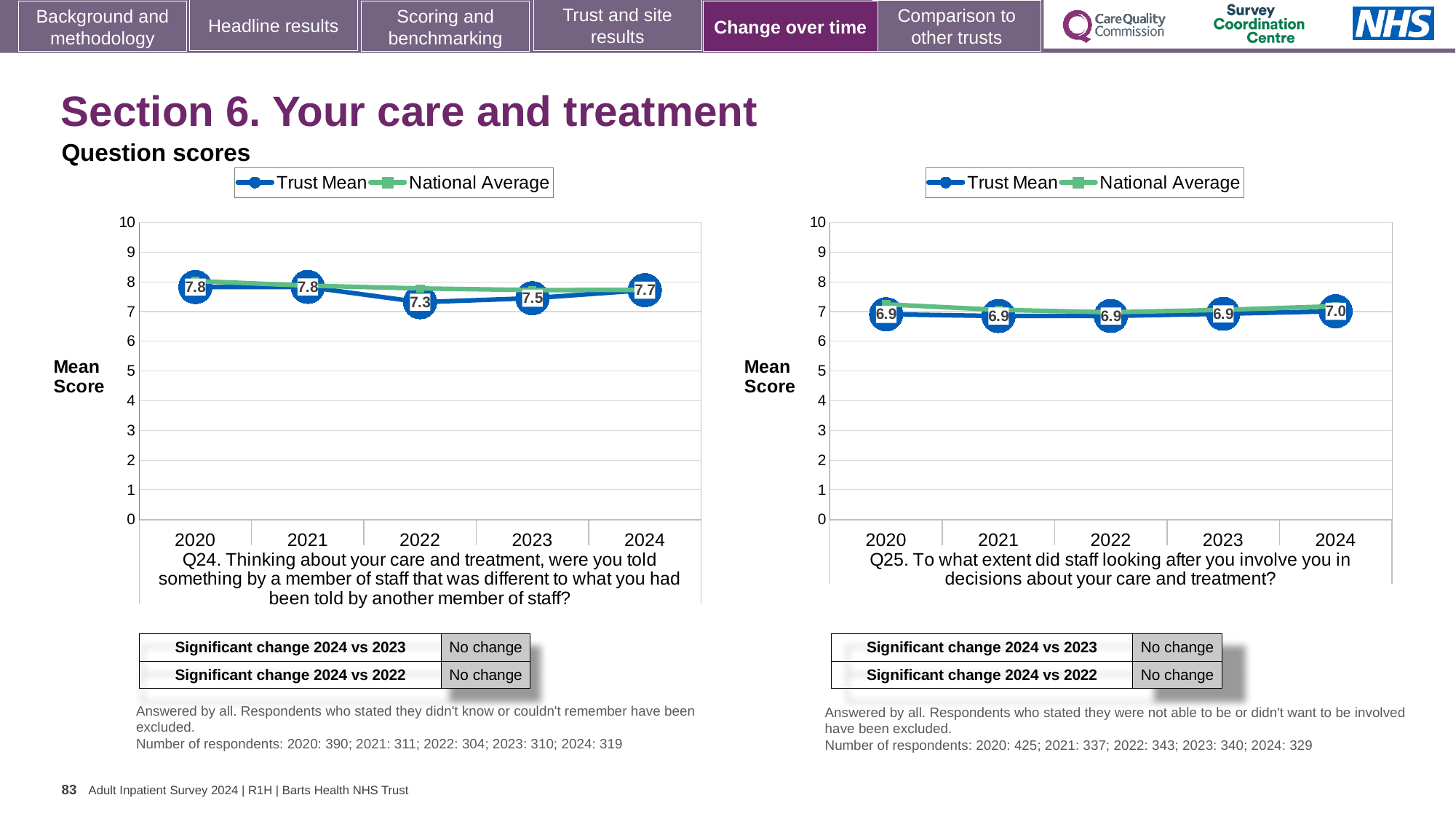
In the Q24 chart on the left, which year has the larger Trust Mean score, 2020 or 2023? 2020 In the Q25 chart on the right, what is the Trust Mean score for 2024? 7.0 In the Q24 chart on the left, which year has the lowest Trust Mean score? 2022 In the Q24 chart on the left, what is the Trust Mean score for 2022? 7.3 What are the two series named in the legend of the Q25 chart on the right? Trust Mean and National Average What kind of chart is the Q25 chart on the right? Line chart How many years are plotted on the x axis of the Q25 chart on the right? 5 In the Q25 chart on the right, is the National Average value for 2020 greater or less than 6? greater In the Q24 chart on the left, what is the Trust Mean score for 2024? 7.7 In the Q24 chart on the left, what is the difference between the Trust Mean scores for 2021 and 2022? 0.5 In the Q24 chart on the left, does the Trust Mean rise or fall from 2022 to 2024? Rise How many series does the legend of the Q24 chart on the left list? 2